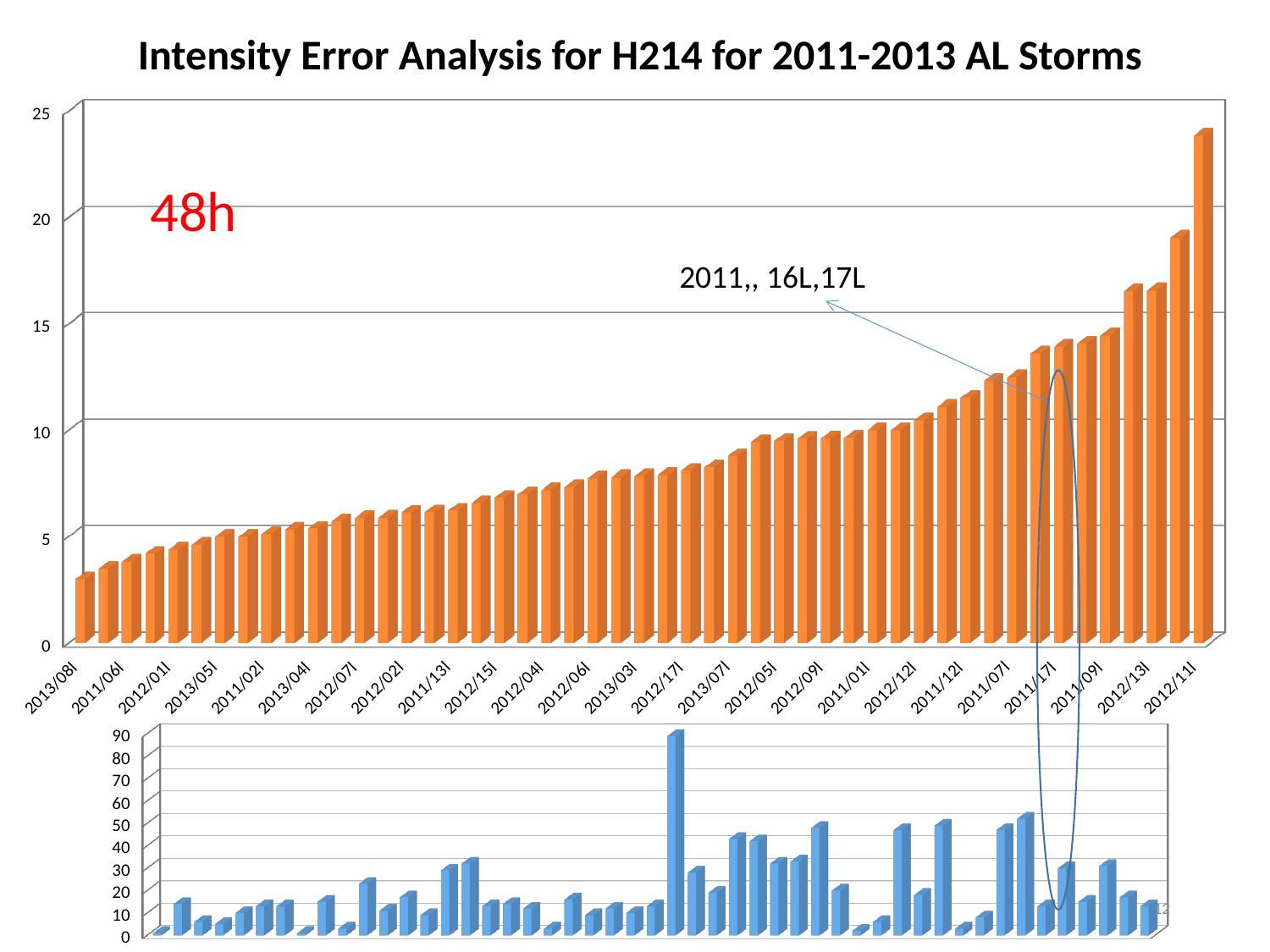
In the top chart, do the bar values rise or fall from left to right along the x axis? rise In the top chart, is the value for 2011/07l greater or less than 10? greater In the top chart, which labelled category has the highest bar? 2012/11l What kind of chart is the top chart titled 'Intensity Error Analysis for H214 for 2011-2013 AL Storms'? bar chart In the top chart, is the value for 2012/13l greater or less than 15? greater In the top chart, which is larger, the value for 2012/13l or the value for 2011/06l? 2012/13l In the top chart, is the value for 2012/11l greater or less than 20? greater What red text label is shown inside the top chart's plot area? 48h In the top chart, which labelled category has the lowest bar? 2013/08l